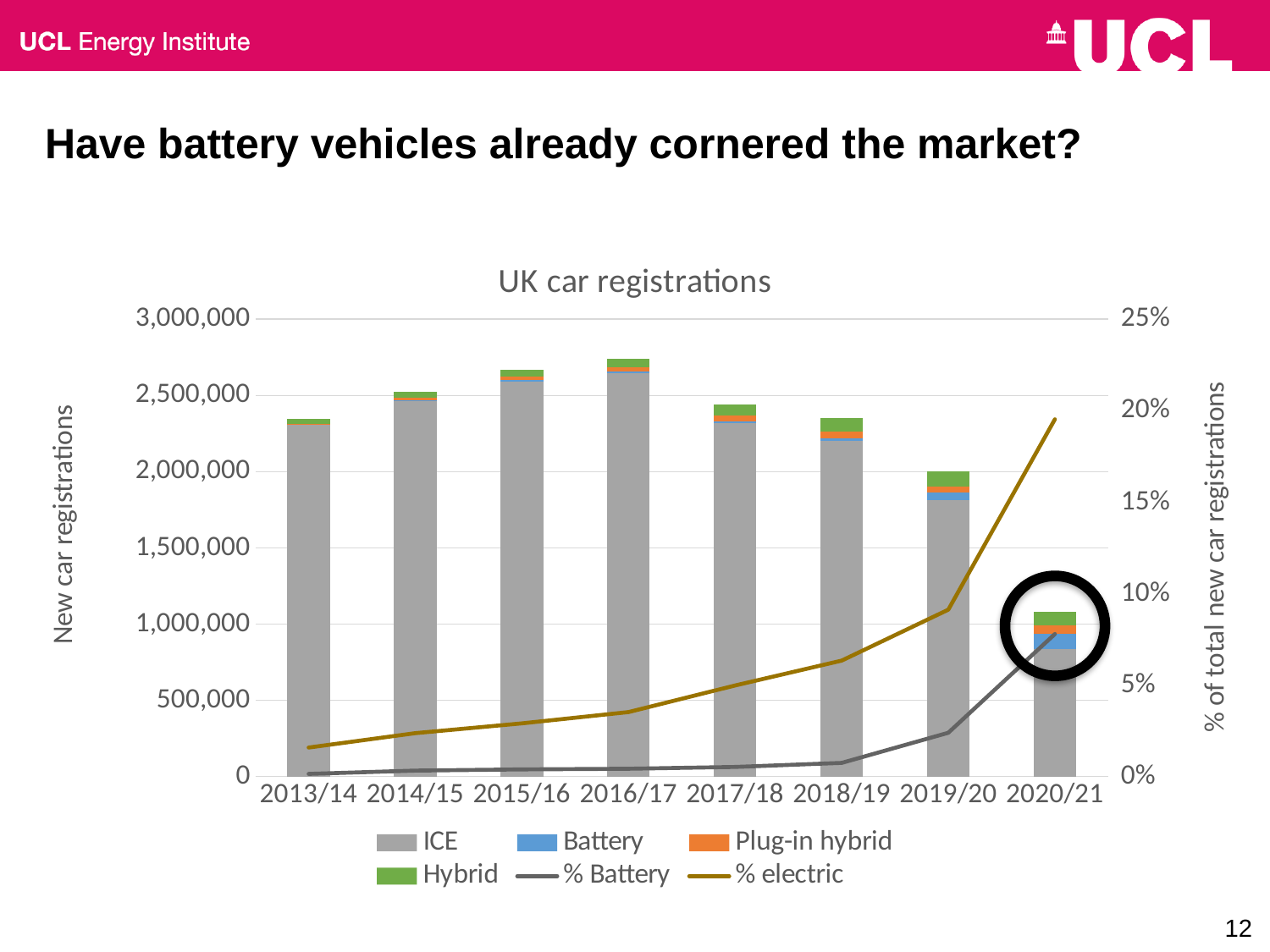
Which year has higher total new car registrations, 2015/16 or 2018/19? 2015/16 Is the total new car registrations for 2020/21 greater or less than 1,500,000? less Does the % electric line rise or fall from 2013/14 to 2020/21? rise How many series does the chart legend list? 6 Which year has the lowest total new car registrations? 2020/21 Is the % Battery value for 2019/20 greater or less than 5%? less Which year has the highest total new car registrations? 2016/17 What kind of chart is this? Stacked bar chart combined with line chart Is the % electric value for 2020/21 greater or less than 15%? greater How many year categories are shown on the x axis? 8 What is the title of the chart? UK car registrations